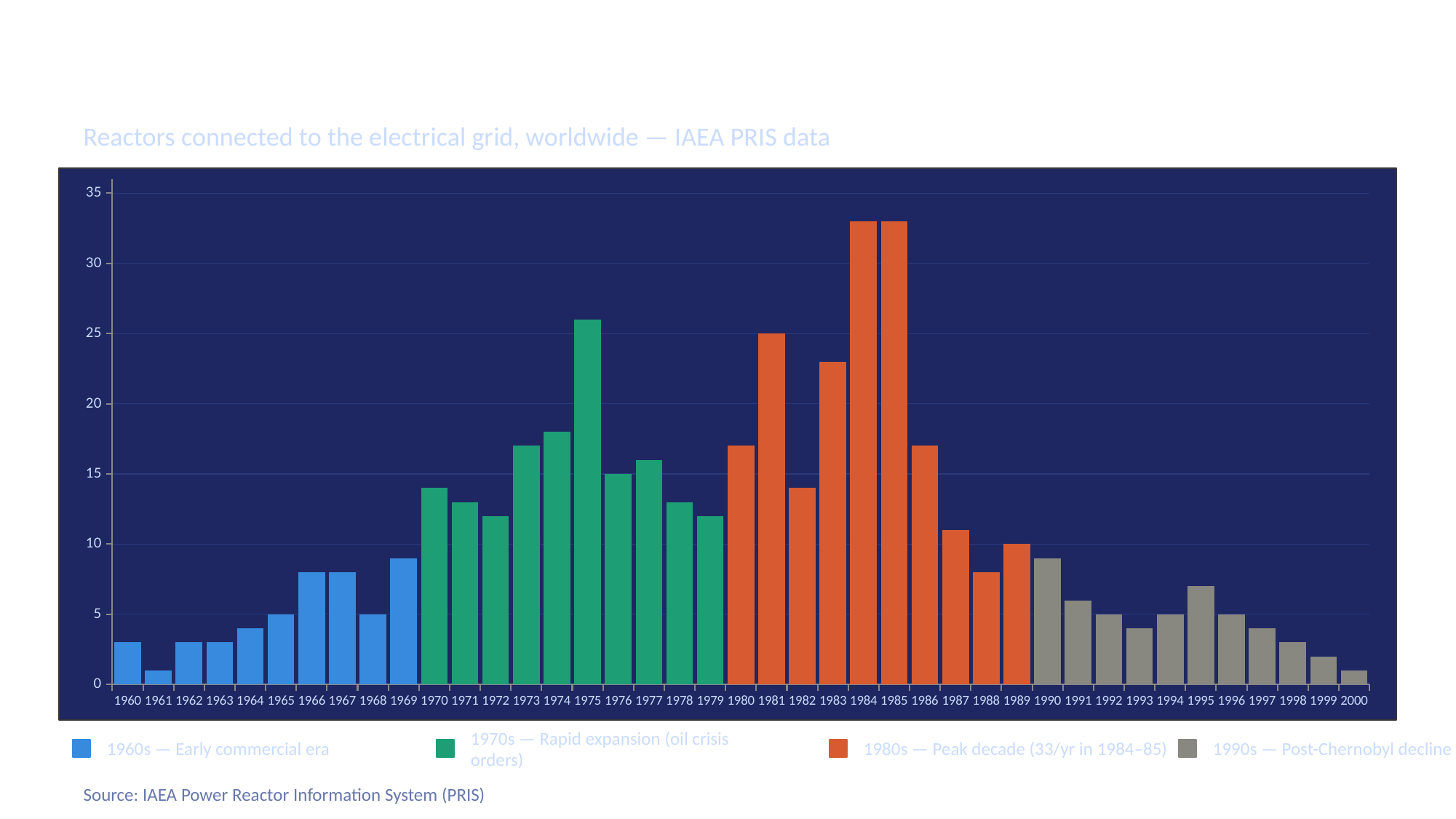
How many years are plotted along the x axis? 41 What kind of chart is shown on the slide? bar chart Which two years have the highest number of reactors connected to the grid? 1984 and 1985 Which year has the larger value, 1981 or 1987? 1981 How many series does the legend list? 4 Is the value for 1990 greater or less than 10? less How many reactors were connected to the grid in 1981? 25 How many reactors were connected to the grid in 1989? 10 According to the legend, how many reactors per year were connected in 1984–85? 33/yr Is the value for 1975 greater or less than 25? greater Which year in the 1990s has the lowest value? 2000 Which year in the 1970s has the highest value? 1975